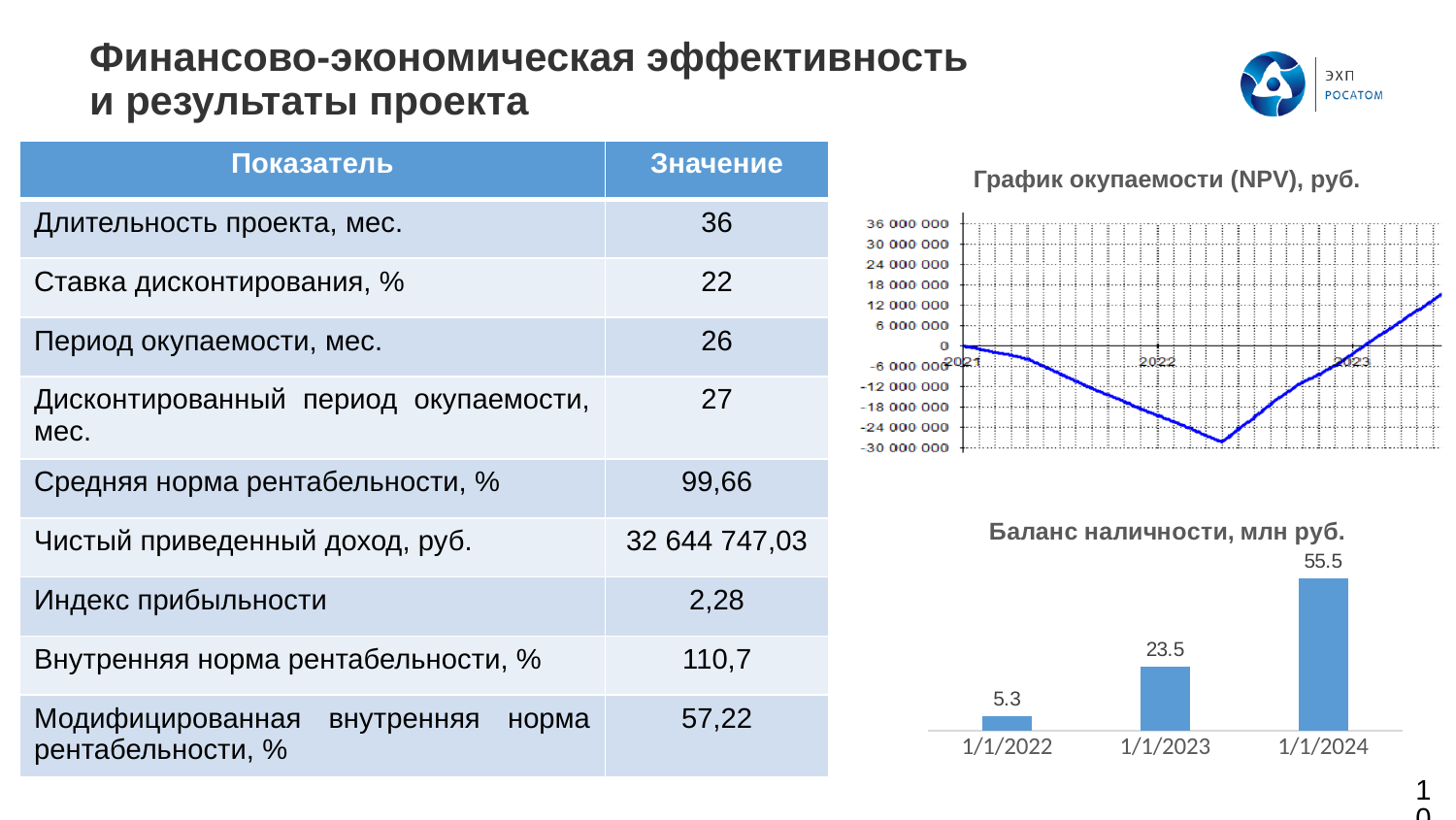
In the 'Баланс наличности, млн руб.' chart, what is the value for 1/1/2023? 23.5 In the 'Баланс наличности, млн руб.' chart, what is the value for 1/1/2022? 5.3 How many bars are shown in the 'Баланс наличности, млн руб.' chart? 3 In the 'Баланс наличности, млн руб.' chart, which is larger: the value for 1/1/2023 or for 1/1/2022? 1/1/2023 In the 'Баланс наличности, млн руб.' chart, what is the difference between the values for 1/1/2024 and 1/1/2023? 32.0 In the 'Баланс наличности, млн руб.' chart, what is the value for 1/1/2024? 55.5 What kind of chart is 'График окупаемости (NPV), руб.'? Line chart In the 'График окупаемости (NPV), руб.' chart, is the lowest point of the line greater or less than -24 000 000? less In the 'Баланс наличности, млн руб.' chart, which date has the lowest value? 1/1/2022 What kind of chart is 'Баланс наличности, млн руб.'? Bar chart In the 'Баланс наличности, млн руб.' chart, do the values rise or fall from 1/1/2022 to 1/1/2024? Rise In the 'Баланс наличности, млн руб.' chart, which date has the highest value? 1/1/2024